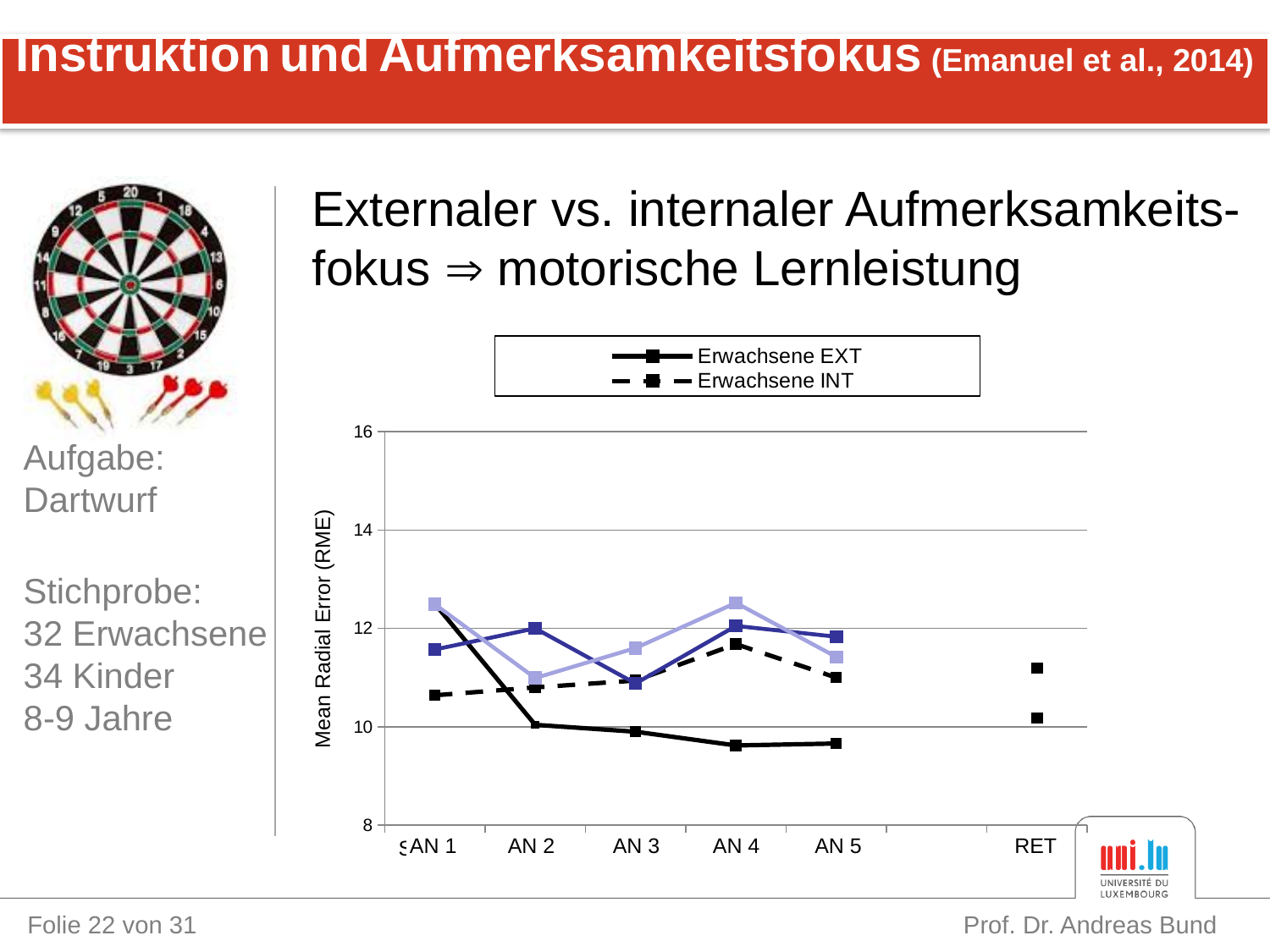
Is the value for Erwachsene EXT at AN 1 greater or less than 12? greater How many categories are labelled on the x axis? 6 Is the value for Erwachsene INT at AN 1 greater or less than 10? greater At AN 5, which is higher: Erwachsene EXT or Erwachsene INT? Erwachsene INT Which series is drawn with a dashed line in the legend? Erwachsene INT What is the label of the y axis? Mean Radial Error (RME) What kind of chart is shown on the slide? line chart Is the value for Erwachsene EXT at AN 4 greater or less than 10? less How many series does the legend list? 2 At AN 1, which is higher: Erwachsene EXT or Erwachsene INT? Erwachsene EXT Does the Erwachsene EXT line rise or fall from AN 1 to AN 5? fall